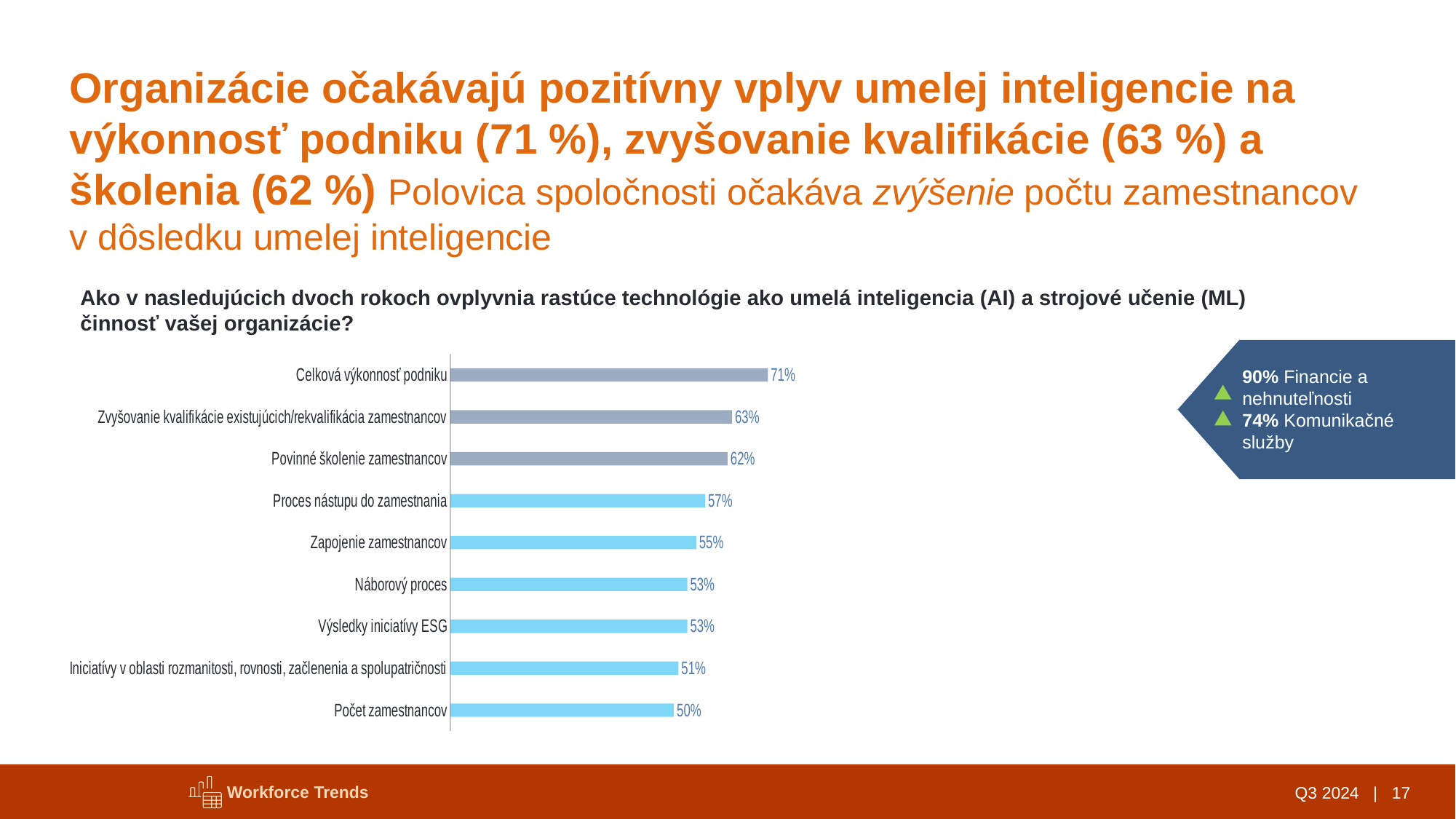
What is the difference between Celková výkonnosť podniku and Počet zamestnancov? 21% How many categories share the value 53%? 2 What is the value for Povinné školenie zamestnancov? 62% Which is larger, Proces nástupu do zamestnania or Náborový proces? Proces nástupu do zamestnania Which category has the highest value? Celková výkonnosť podniku What is the value for Počet zamestnancov? 50% What is the difference between Zvyšovanie kvalifikácie existujúcich/rekvalifikácia zamestnancov and Zapojenie zamestnancov? 8% What is the value for Celková výkonnosť podniku? 71% What kind of chart is shown on the slide? Bar chart Which category has the lowest value? Počet zamestnancov How many categories are shown in the chart? 9 What is the value for Proces nástupu do zamestnania? 57%